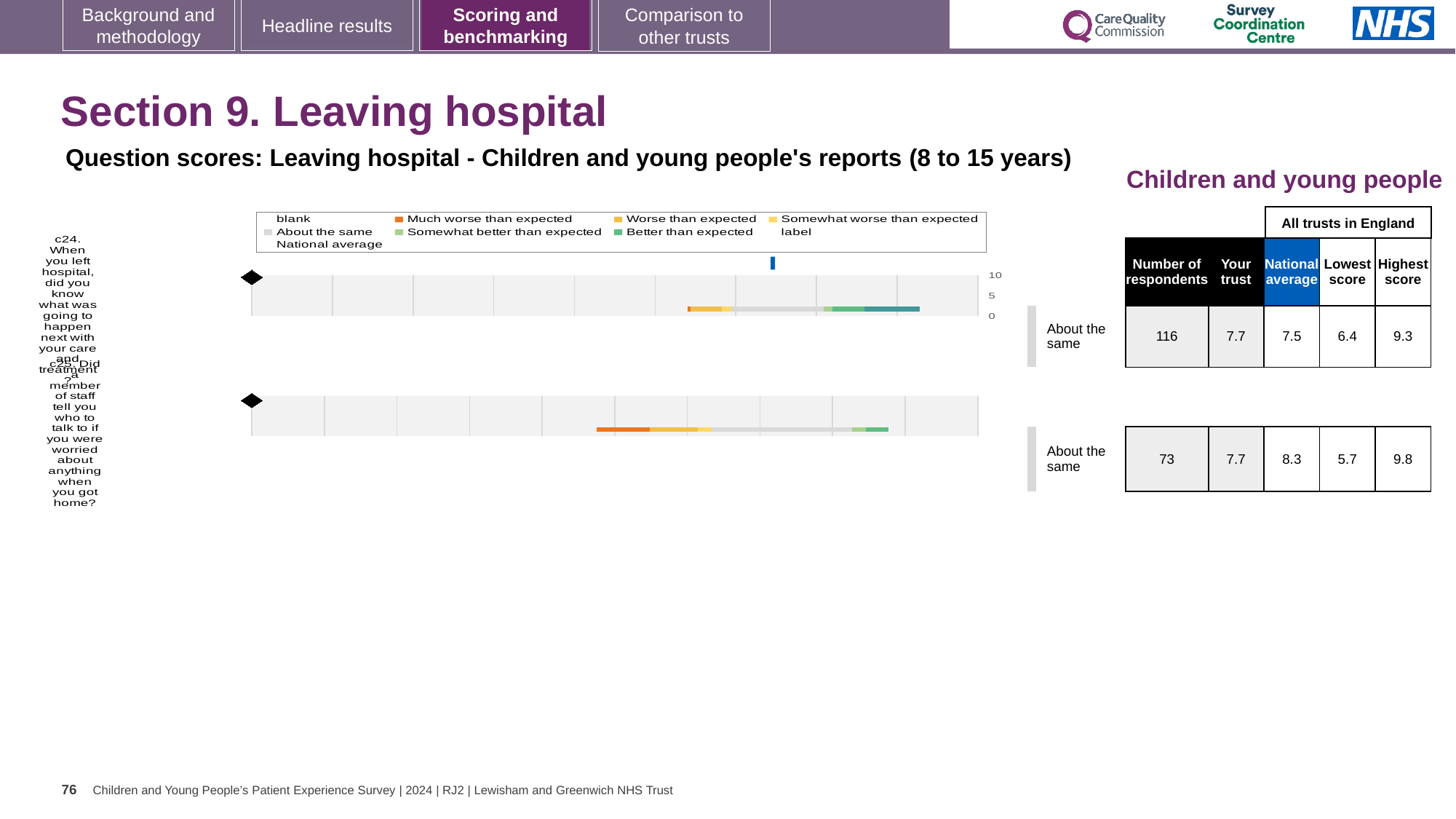
How many survey questions are plotted in the chart? 2 What benchmark category is the trust given for question c24? About the same What is the lowest score among all trusts in England for question c25? 5.7 What is the 'Your trust' score for question c24 (When you left hospital, did you know what was going to happen next with your care and treatment?)? 7.7 How many respondents answered question c25? 73 Which colour in the legend represents 'Much worse than expected'? orange What is the national average score for question c25 (Did a member of staff tell you who to talk to if you were worried about anything when you got home?)? 8.3 What kind of chart is used to show the question scores? bar chart For question c24, is the trust's score higher or lower than the national average? higher What is the highest score among all trusts in England for question c24? 9.3 How many respondents answered question c24? 116 What is the difference between the highest and lowest trust scores for question c25? 4.1